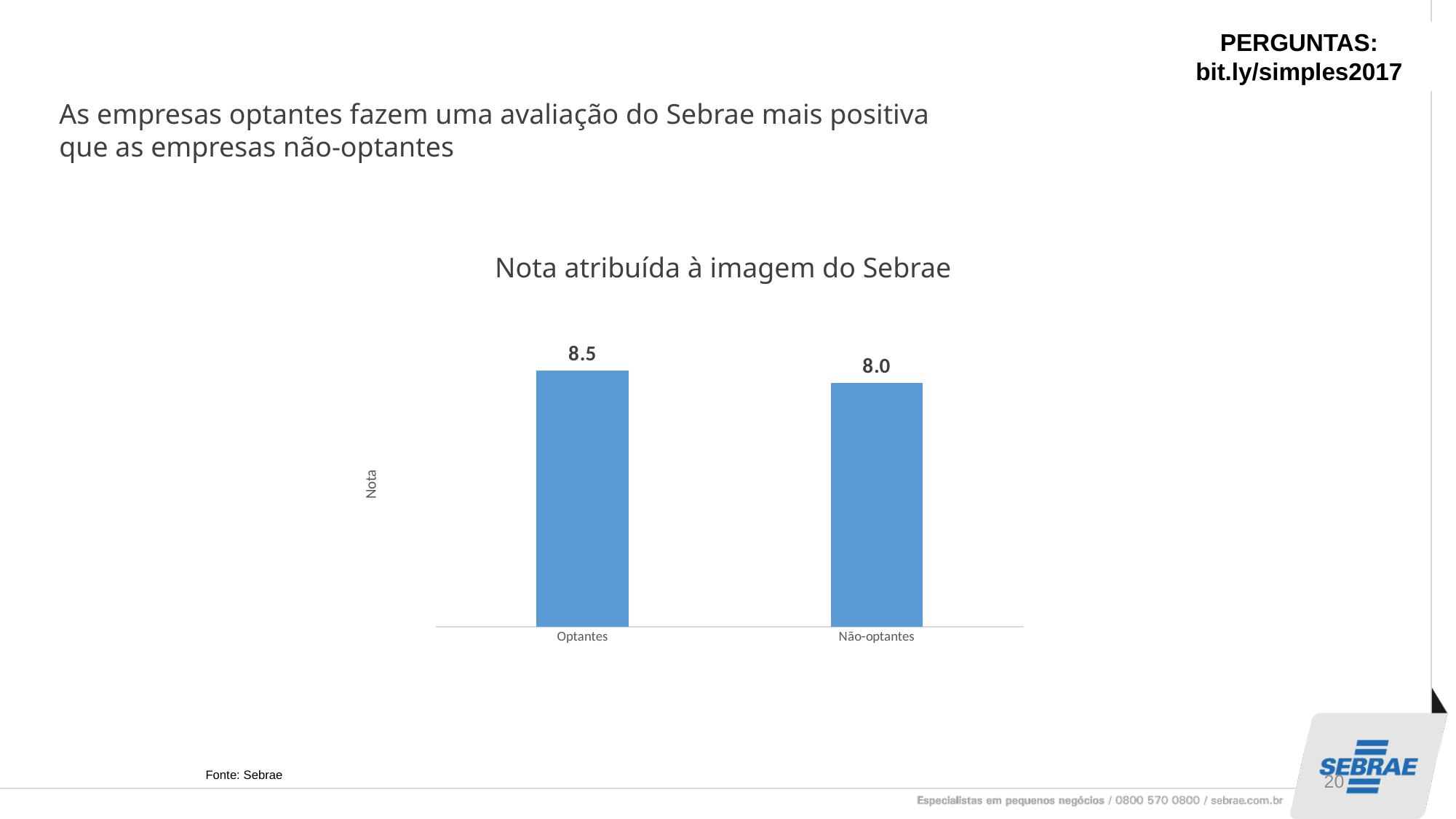
Which category has the highest value? Optantes What is the title of the chart? Nota atribuída à imagem do Sebrae Which is larger, the value for Optantes or the value for Não-optantes? Optantes Which category has the lowest value? Não-optantes What is the value for Optantes? 8.5 What kind of chart is shown on the slide? bar chart How many categories are shown in the chart? 2 What is the label of the vertical axis? Nota What is the difference between the values for Optantes and Não-optantes? 0.5 What is the value for Não-optantes? 8.0